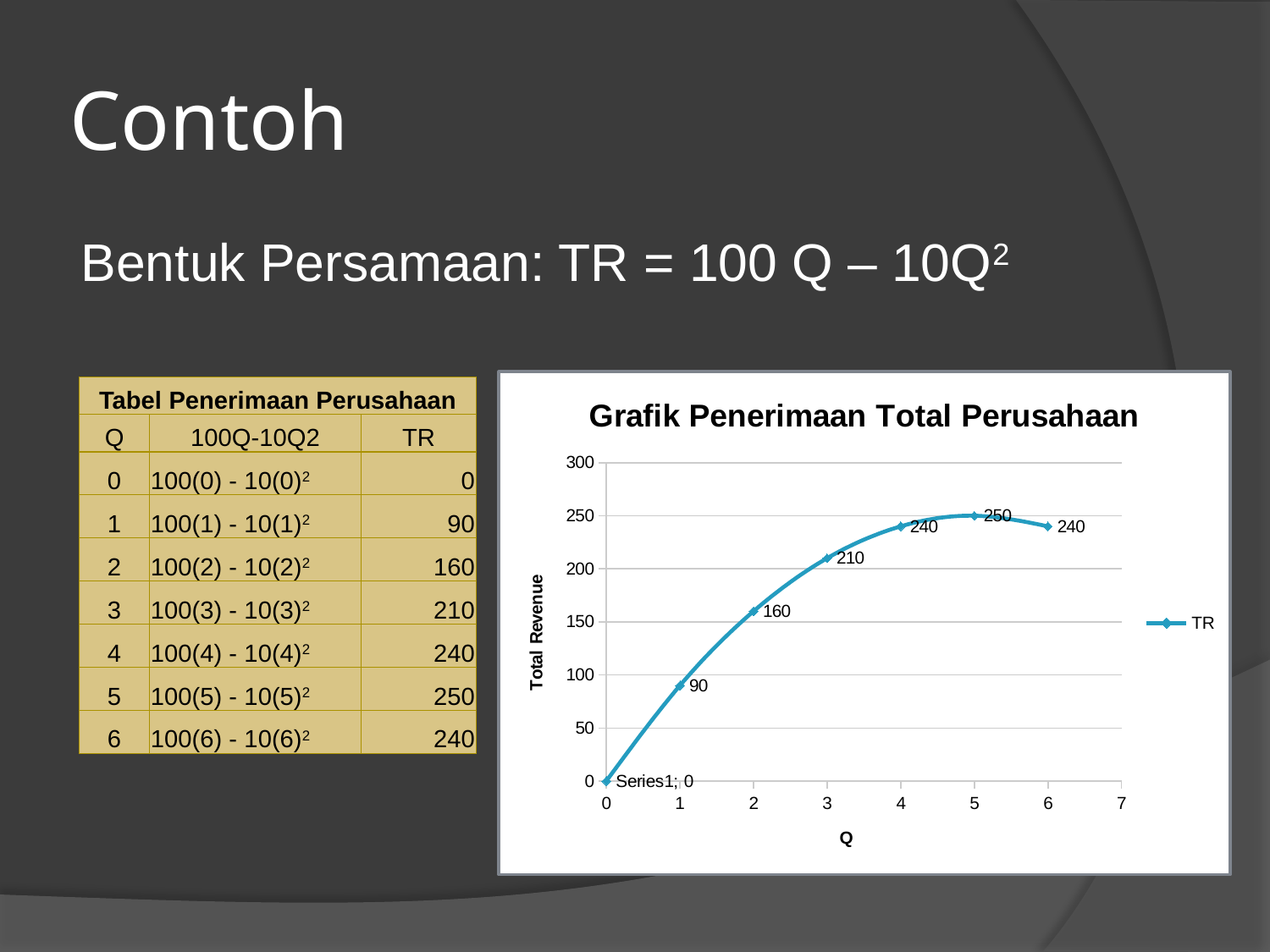
What is the TR value at Q = 1? 90 How many data points are plotted on the TR line? 7 What is the difference between the TR value at Q = 5 and at Q = 4? 10 Which is larger, the TR value at Q = 2 or at Q = 3? Q = 3 Does TR rise or fall between Q = 5 and Q = 6? fall What is the title of the chart? Grafik Penerimaan Total Perusahaan How many series does the legend list? 1 At which value of Q is TR highest? 5 What is the Total Revenue (TR) value at Q = 3? 210 What type of chart is shown on the slide? line chart What is the TR value at Q = 2? 160 What is the highest TR value plotted on the chart? 250